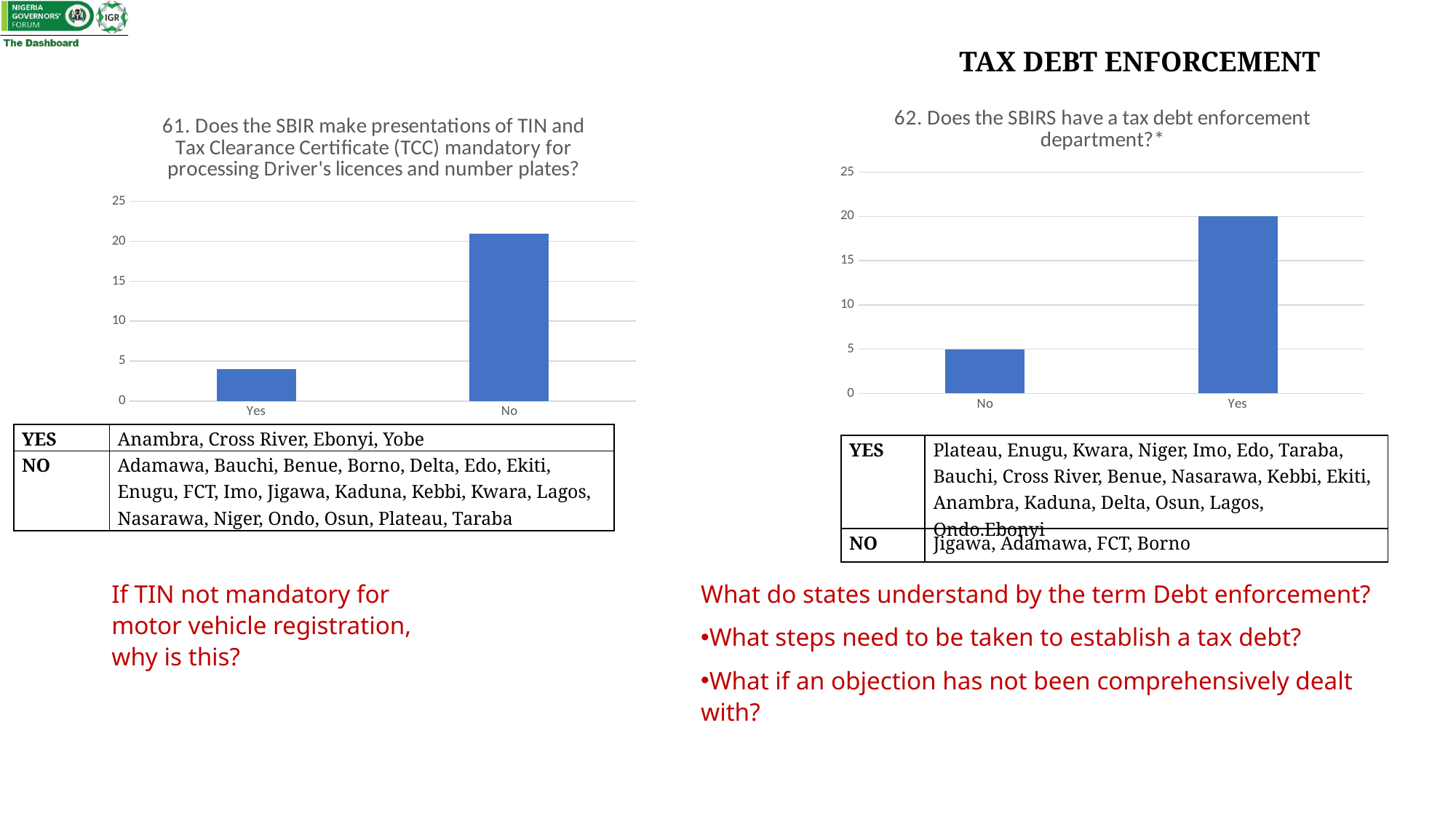
In the left chart (question 61), is the value for Yes greater or less than 5? less What is the highest value shown on the y axis of the right chart (question 62)? 25 What kind of chart is the left chart (question 61)? bar chart In the right chart (question 62), which is larger, Yes or No? Yes What is the title of the right chart? 62. Does the SBIRS have a tax debt enforcement department?* In the right chart (question 62), what is the difference between the Yes and No values? 15 In the left chart (question 61), is the value for No greater or less than 20? greater How many categories are shown on the x axis of the left chart (question 61)? 2 In the left chart (question 61), which category has the lowest bar? Yes In the left chart (question 61), which category has the higher bar? No In the right chart (question 62), what is the value for No? 5 In the right chart (question 62), what is the value for Yes? 20